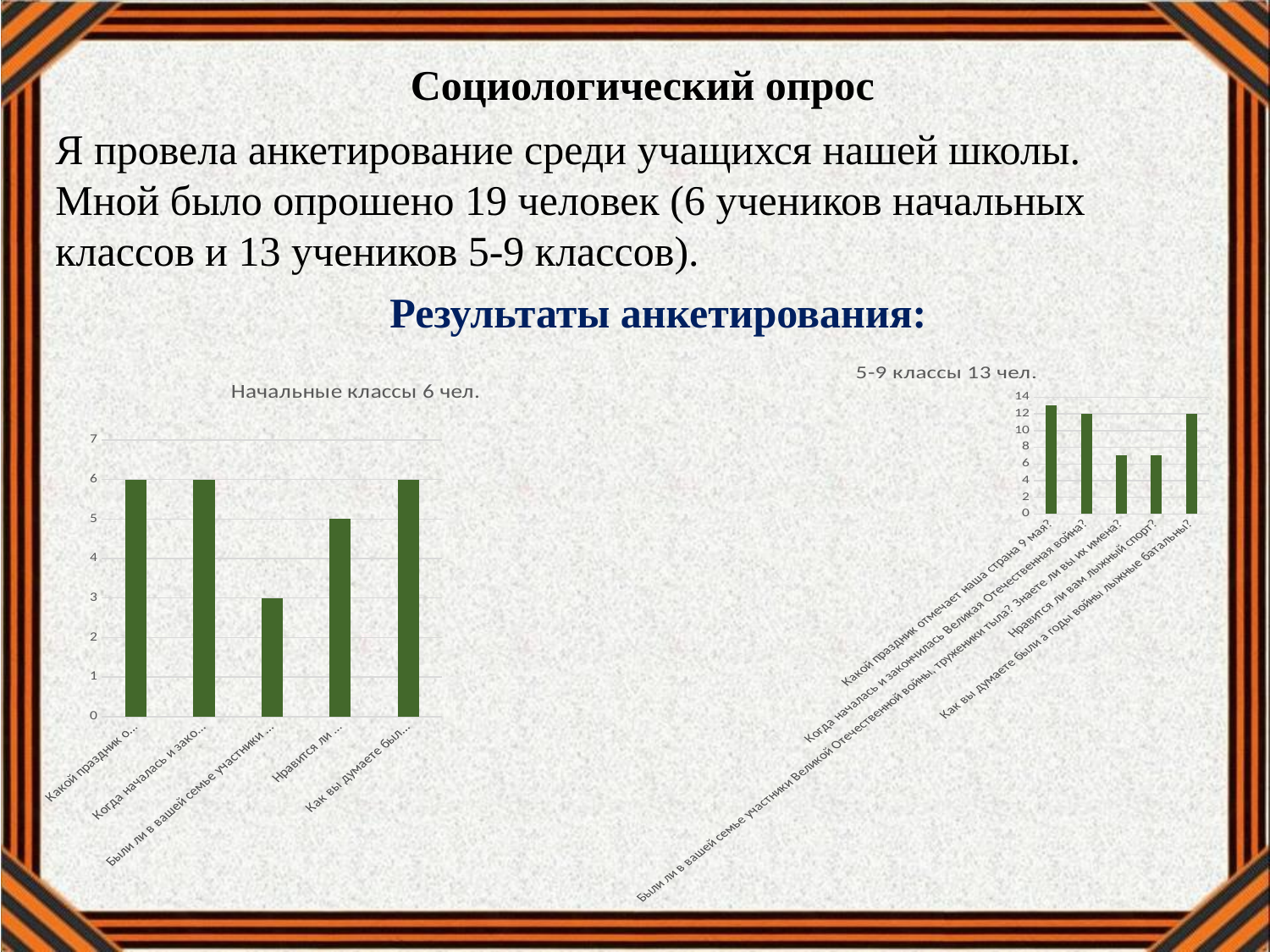
In the 'Начальные классы 6 чел.' chart, what is the value of the fourth bar ('Нравится ли ...')? 5 In the 'Начальные классы 6 чел.' chart, what is the value of the third bar ('Были ли в вашей семье участники ...')? 3 In the 'Начальные классы 6 чел.' chart, how many bars (categories) are plotted? 5 In the '5-9 классы 13 чел.' chart, which category has the highest value? Какой праздник отмечает наша страна 9 мая? What type of chart is the 'Начальные классы 6 чел.' chart on the left? bar chart In the 'Начальные классы 6 чел.' chart, what is the difference between the first bar and the third bar? 3 In the '5-9 классы 13 чел.' chart, which is larger: the value for 'Какой праздник отмечает наша страна 9 мая?' or the value for 'Нравится ли вам лыжный спорт?'? Какой праздник отмечает наша страна 9 мая? In the '5-9 классы 13 чел.' chart, how many categories are plotted? 5 In the '5-9 классы 13 чел.' chart, is the value for 'Нравится ли вам лыжный спорт?' greater or less than 10? less In the '5-9 классы 13 чел.' chart, what is the value for 'Когда началась и закончилась Великая Отечественная война?'? 12 What is the title of the chart on the right side of the slide? 5-9 классы 13 чел. In the 'Начальные классы 6 чел.' chart, which bar is the lowest? Были ли в вашей семье участники ... (third bar)